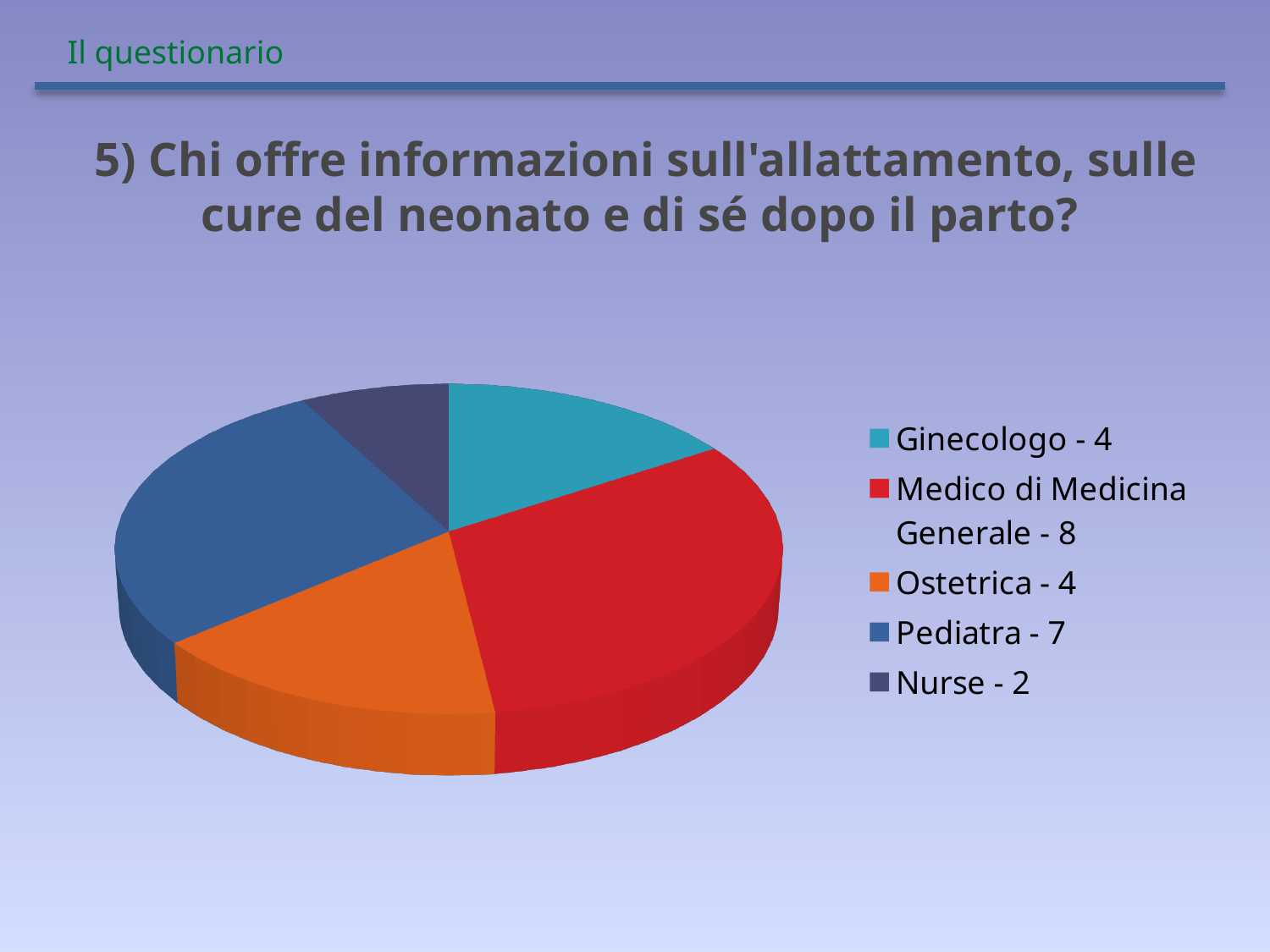
Which is larger, the value for Pediatra or the value for Ginecologo? Pediatra How many categories does the pie chart have? 5 What share of the pie does Medico di Medicina Generale represent? 32% What is the value for Medico di Medicina Generale? 8 What colour is the Ostetrica slice in the pie chart? Orange What is the value for Nurse? 2 Which category has the largest value? Medico di Medicina Generale Which category has the smallest value? Nurse What type of chart is shown on the slide? Pie chart What is the value for Pediatra? 7 What is the difference between the values for Medico di Medicina Generale and Pediatra? 1 What is the total of all the values in the pie chart? 25